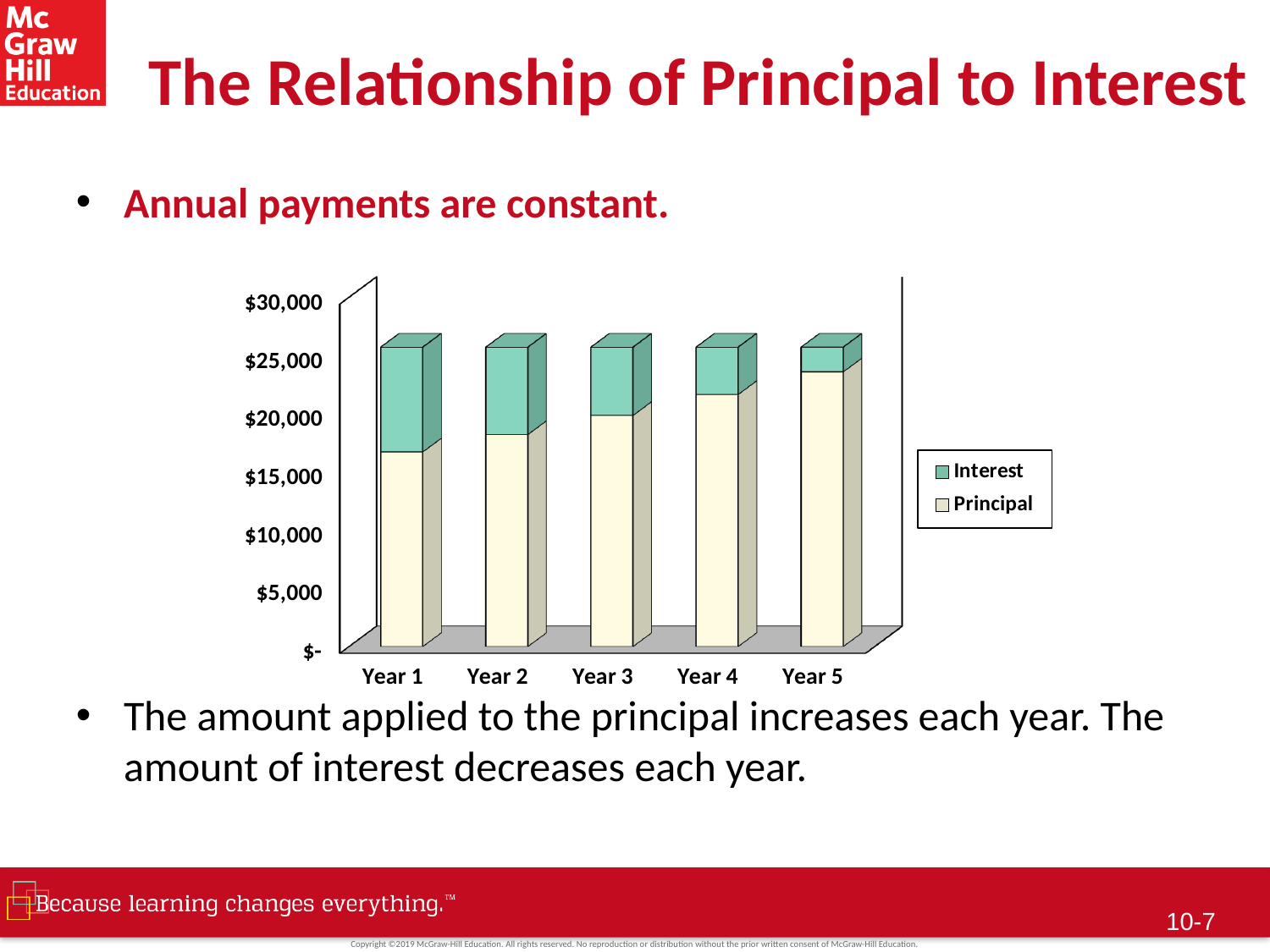
How many years are shown on the x axis of the chart? 5 Does the Interest portion rise or fall from Year 1 to Year 5? Fall How many series does the chart's legend list? 2 Is the Principal value for Year 5 greater or less than $20,000? greater Does the Principal portion rise or fall from Year 1 to Year 5? Rise Which year has the smallest Interest portion? Year 5 Which year has the smallest Principal portion? Year 1 Which series are listed in the chart's legend? Interest and Principal Is the Principal value for Year 1 greater or less than $15,000? greater Which year has the largest Interest portion? Year 1 What kind of chart is shown on the slide? Stacked bar chart Which year has the largest Principal portion? Year 5